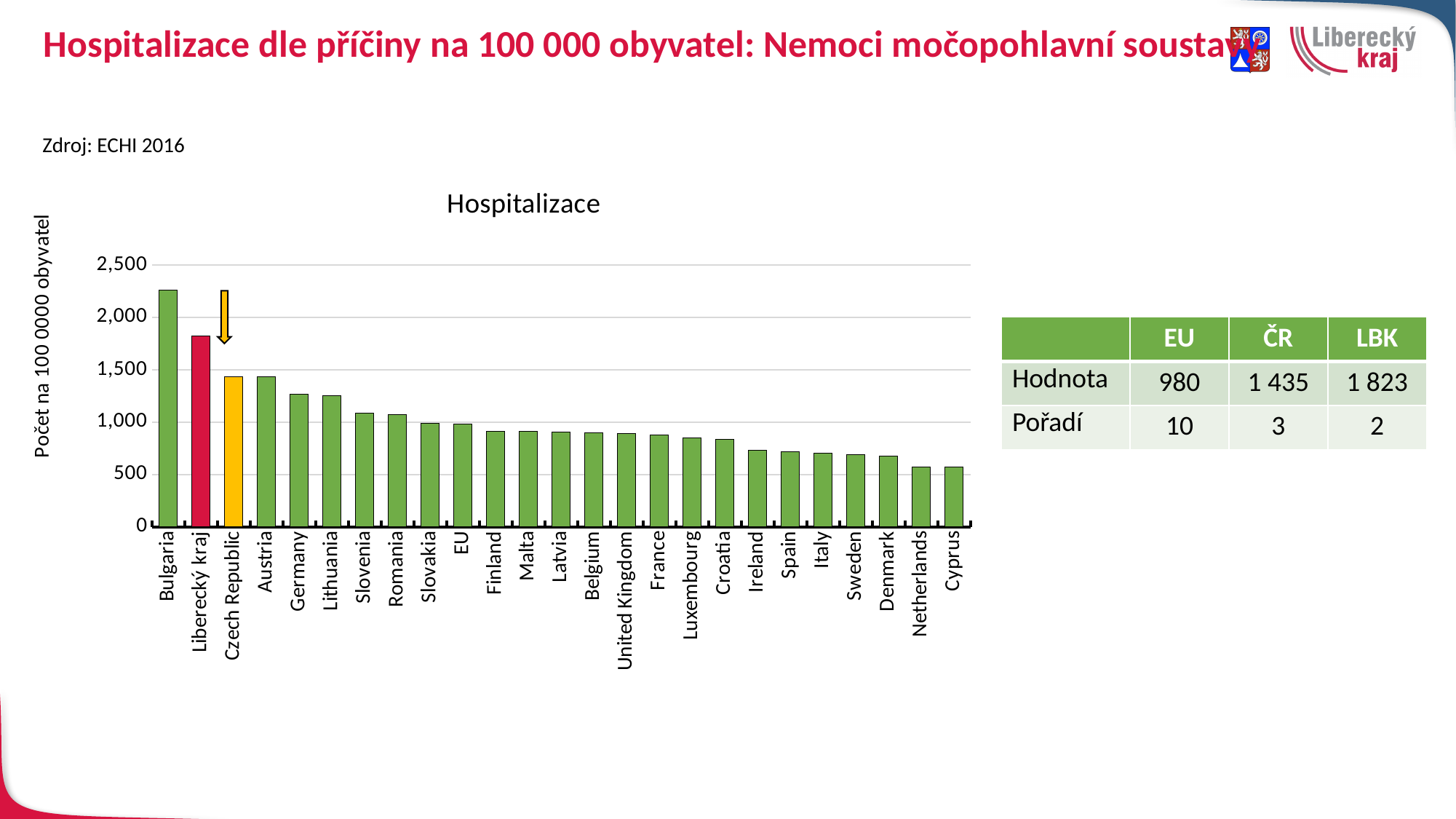
What is the difference between the values for LBK and ČR shown in the table? 388 Is the value for Spain greater or less than 1,000? less What kind of chart is shown on the slide? bar chart How many categories (bars) are plotted in the chart? 25 Is the value for Bulgaria greater or less than 2,000? greater What is the title of the chart? Hospitalizace Which category has the highest value in the chart? Bulgaria According to the table, what is the value for ČR (Czech Republic)? 1 435 Which is larger, the value for Bulgaria or the value for Liberecký kraj? Bulgaria Do the values rise or fall from left to right along the x axis? fall According to the table, what is the value for EU? 980 According to the table, what is the value for LBK (Liberecký kraj)? 1 823